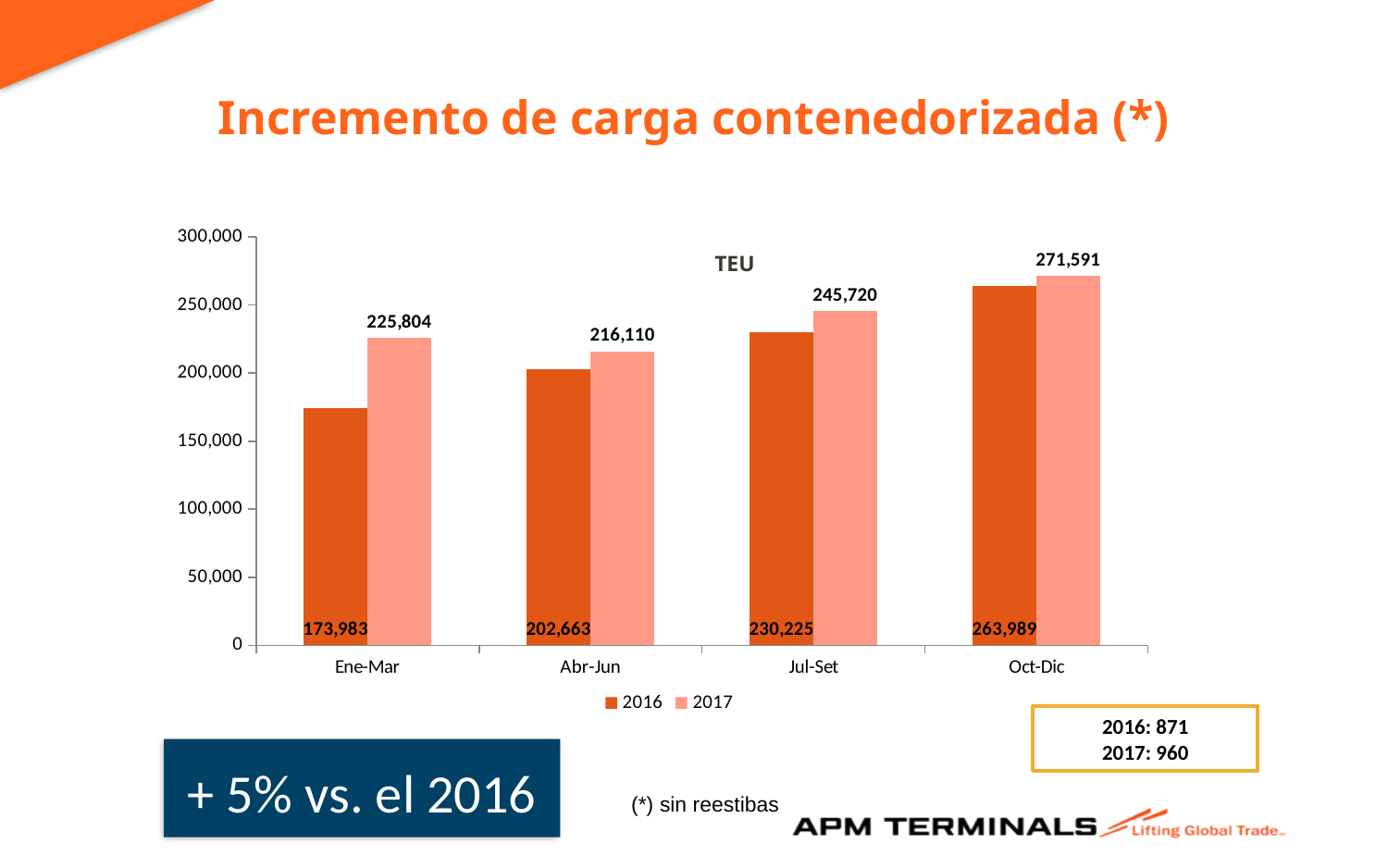
Which period has the highest 2017 value? Oct-Dic Which is larger, the 2017 value for Ene-Mar or the 2017 value for Abr-Jun? Ene-Mar What is the 2017 value for Jul-Set? 245,720 What is the 2016 value for Oct-Dic? 263,989 What is the 2017 value for Ene-Mar? 225,804 Is the 2016 value for Ene-Mar greater or less than 200,000? less What is the difference between the 2017 and 2016 values for Oct-Dic? 7,602 What is the 2016 value for Abr-Jun? 202,663 How many periods are shown on the x axis? 4 Which period has the lowest 2016 value? Ene-Mar Do the 2016 values rise or fall from Ene-Mar to Oct-Dic? rise What is the difference between the 2017 and 2016 values for Ene-Mar? 51,821